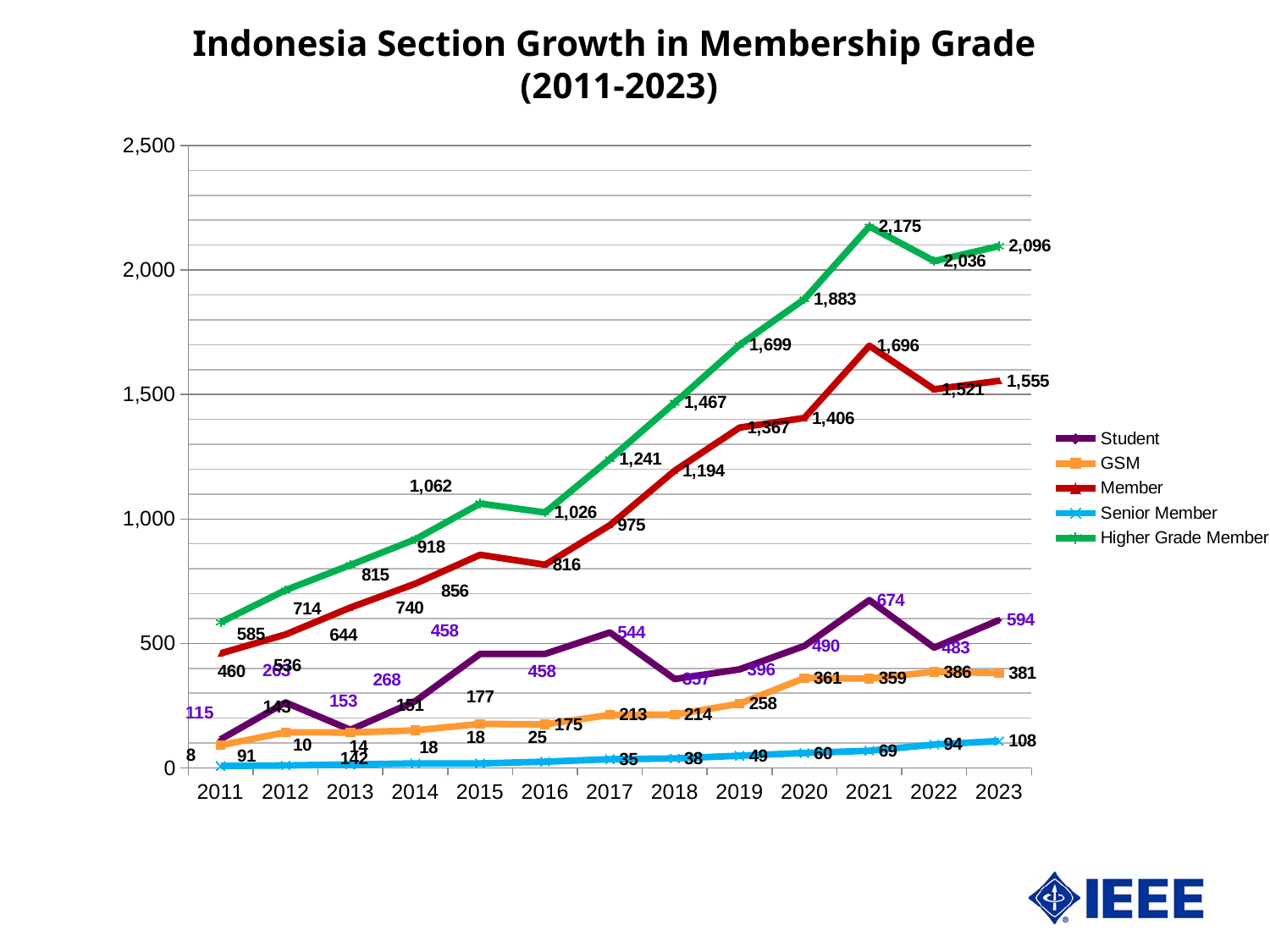
What is the value for Higher Grade Member in 2011? 585 In which year does the Higher Grade Member series reach its highest value? 2021 How many years are plotted on the x axis? 13 What is the value for Senior Member in 2023? 108 What is the difference between the Higher Grade Member value and the Member value in 2023? 541 What is the value for Higher Grade Member in 2021? 2,175 What is the value for Member in 2023? 1,555 Does the Member series generally rise or fall from 2011 to 2023? Rise In which year is the Senior Member value lowest? 2011 How many series does the legend list? 5 What kind of chart is shown on the slide? Line chart In 2021, which is larger: the Student value or the GSM value? Student